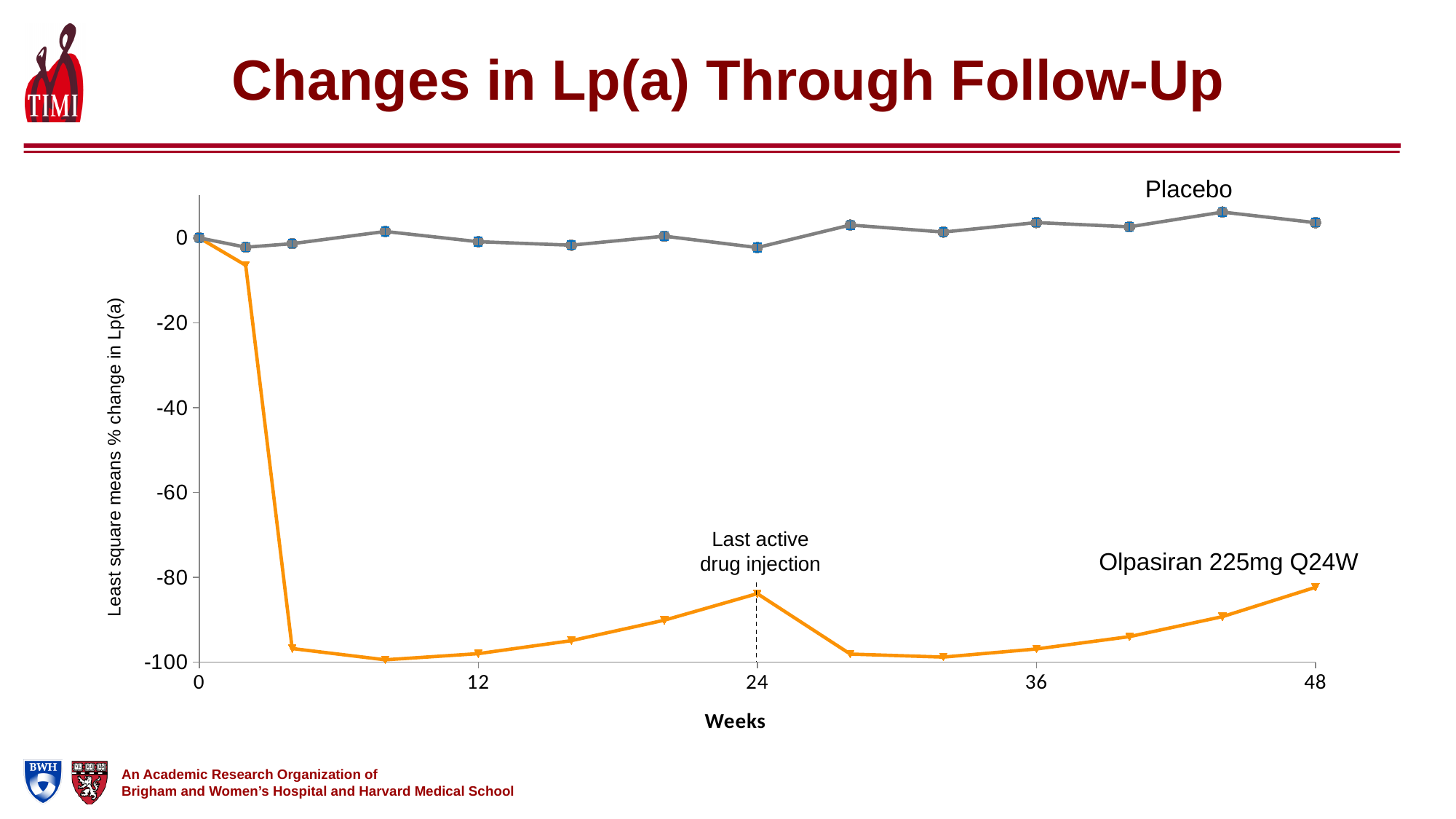
Between week 0 and week 4, do the values for Olpasiran 225mg Q24W rise or fall? fall Is the value for Placebo at week 48 greater or less than -20? greater At which week does the annotation 'Last active drug injection' appear? 24 How many series are plotted on the chart? 2 What are the names of the two series plotted on the chart? Placebo and Olpasiran 225mg Q24W At week 24, which series has the higher value, Placebo or Olpasiran 225mg Q24W? Placebo Is the value for Olpasiran 225mg Q24W at week 8 greater or less than -60? less What is the value for both series at week 0? 0 Is the value for Olpasiran 225mg Q24W at week 12 greater or less than -80? less What kind of chart is shown on the slide? line chart Between week 28 and week 48, do the values for Olpasiran 225mg Q24W rise or fall? rise